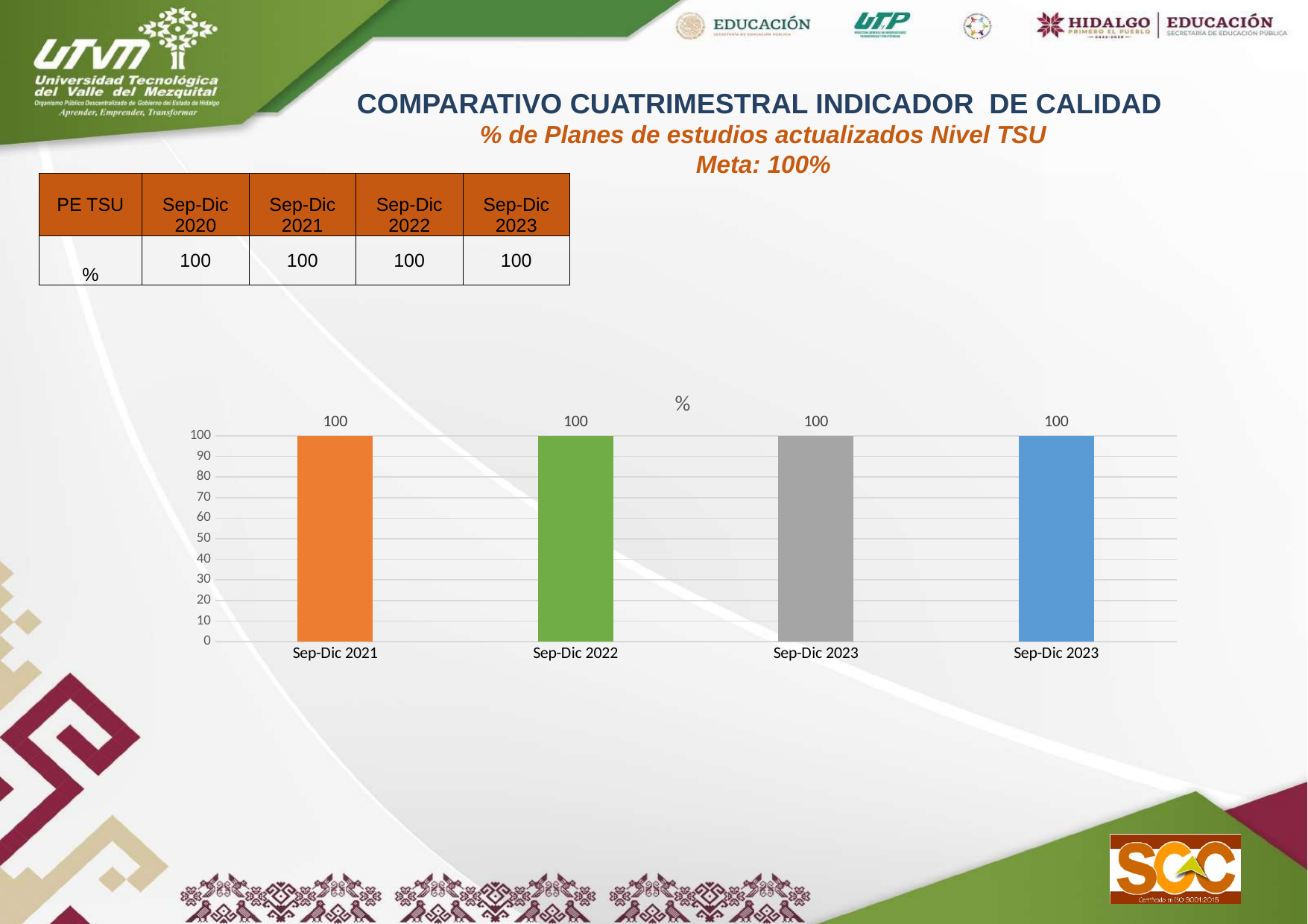
What value is shown above the blue bar in the chart? 100 What value is shown above the gray bar in the chart? 100 What is the value for Sep-Dic 2021 in the chart? 100 What is the difference between the values for Sep-Dic 2021 and Sep-Dic 2022? 0 What is the title of the chart? % Is the value for Sep-Dic 2022 greater or less than 50? greater What is the value for Sep-Dic 2022 in the chart? 100 What kind of chart is shown on the slide? bar chart How many bars are plotted in the chart? 4 What colour is the bar for Sep-Dic 2021? orange Do the values rise, fall, or stay the same across the categories on the x axis? stay the same Is the value for Sep-Dic 2021 larger than, smaller than, or equal to the value for Sep-Dic 2022? equal